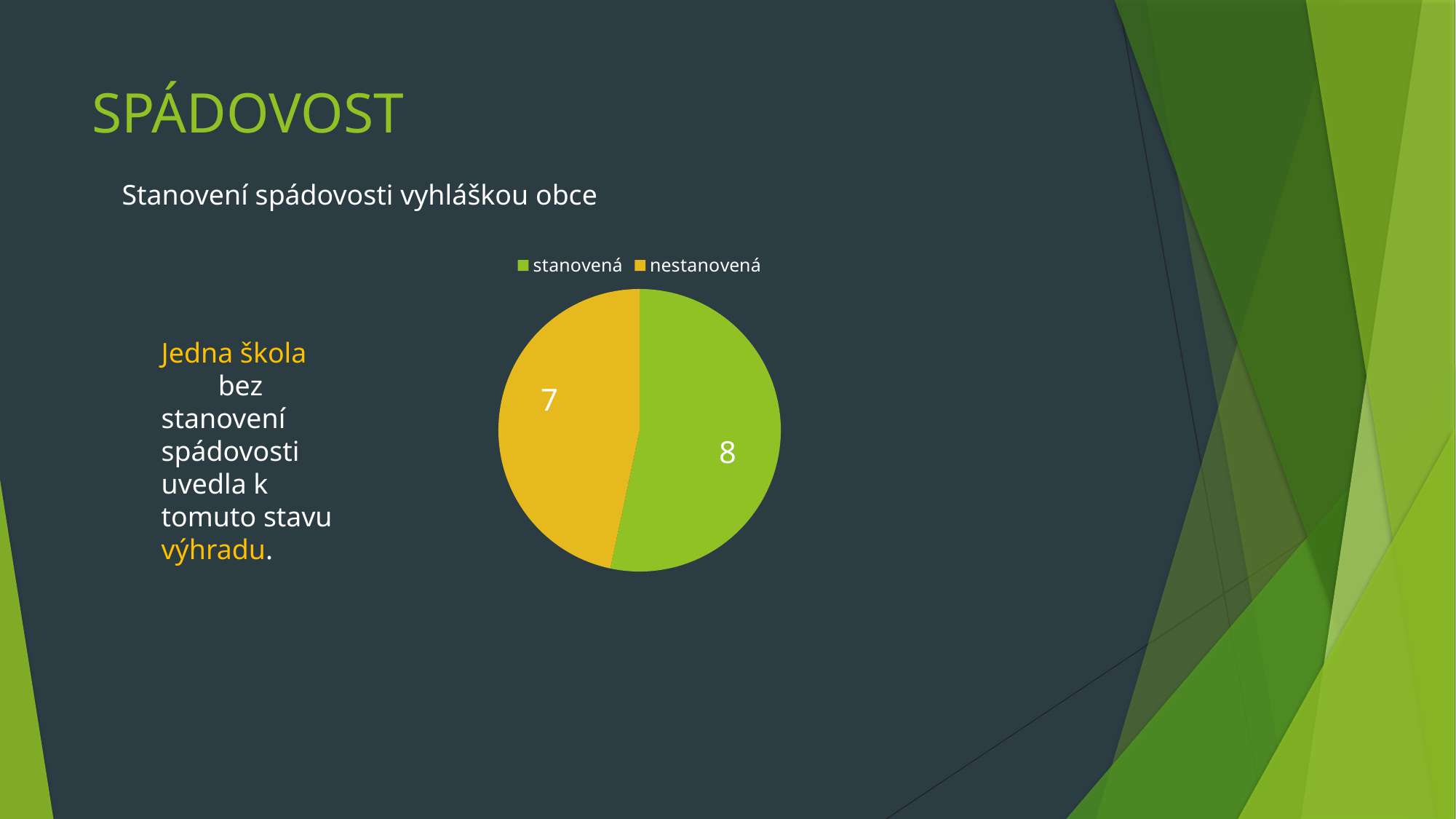
What is the value for "nestanovená" in the pie chart? 7 What kind of chart is shown on the slide? pie chart What is the value for "stanovená" in the pie chart? 8 How many entries does the chart legend list? 2 What colour is the "stanovená" slice in the pie chart? green What is the total of the values shown in the pie chart? 15 What colour is the "nestanovená" slice in the pie chart? yellow/gold Which is larger, the value for "stanovená" or for "nestanovená"? stanovená How many slices does the pie chart have? 2 What is the difference between the values for "stanovená" and "nestanovená"? 1 Which category has the largest slice in the pie chart? stanovená Which category has the smallest slice in the pie chart? nestanovená